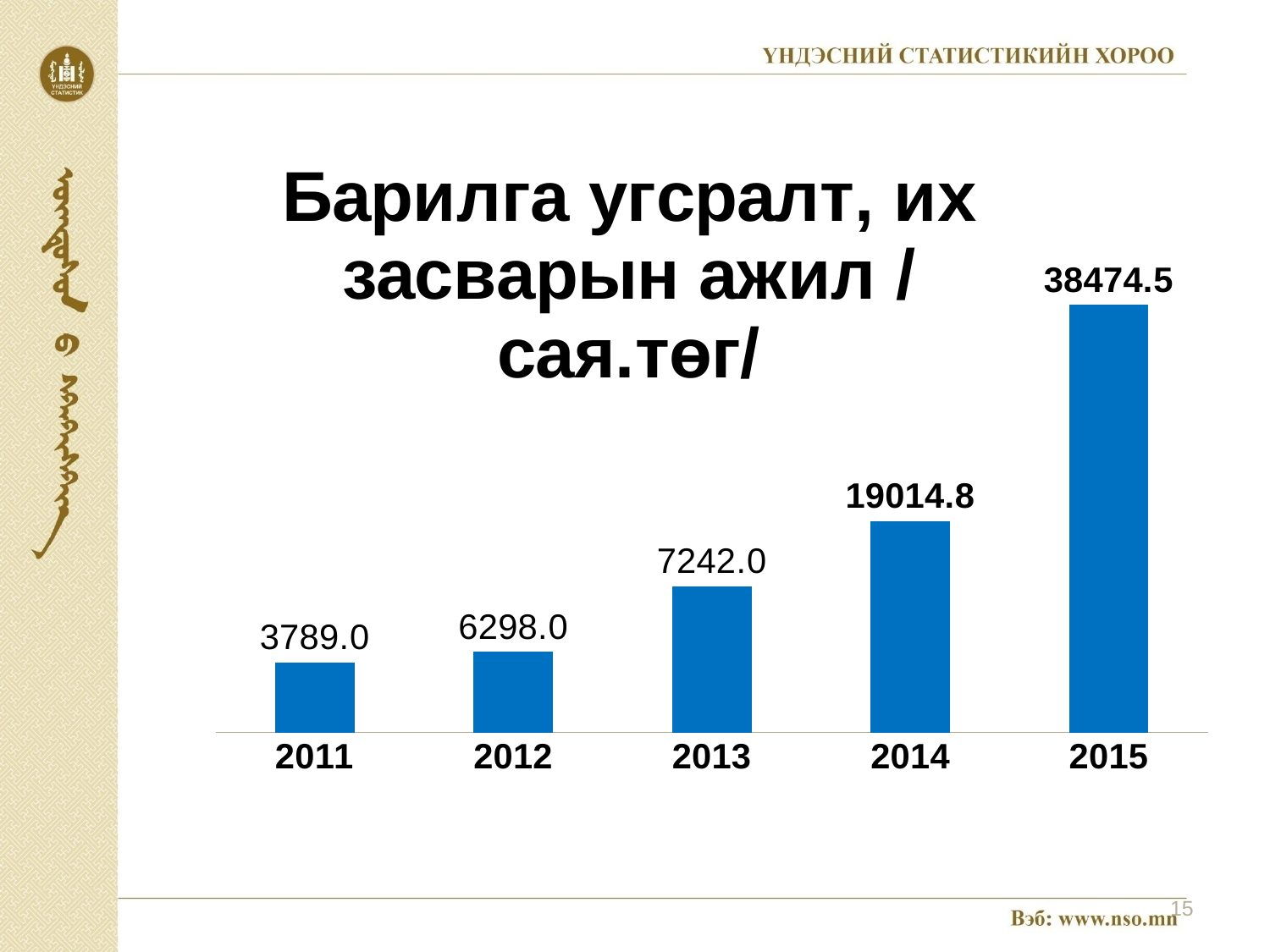
What is the value for 2014? 19014.8 Which is larger, the value for 2013 or the value for 2012? 2013 How many years are shown on the chart? 5 Do the values rise or fall from 2011 to 2015? Rise What kind of chart is shown on the slide? Bar chart What is the difference between the values for 2015 and 2014? 19459.7 Which year has the highest value? 2015 What is the difference between the values for 2012 and 2011? 2509.0 Which year has the lowest value? 2011 What is the value for 2013? 7242.0 What is the value for 2011? 3789.0 What is the value for 2015? 38474.5